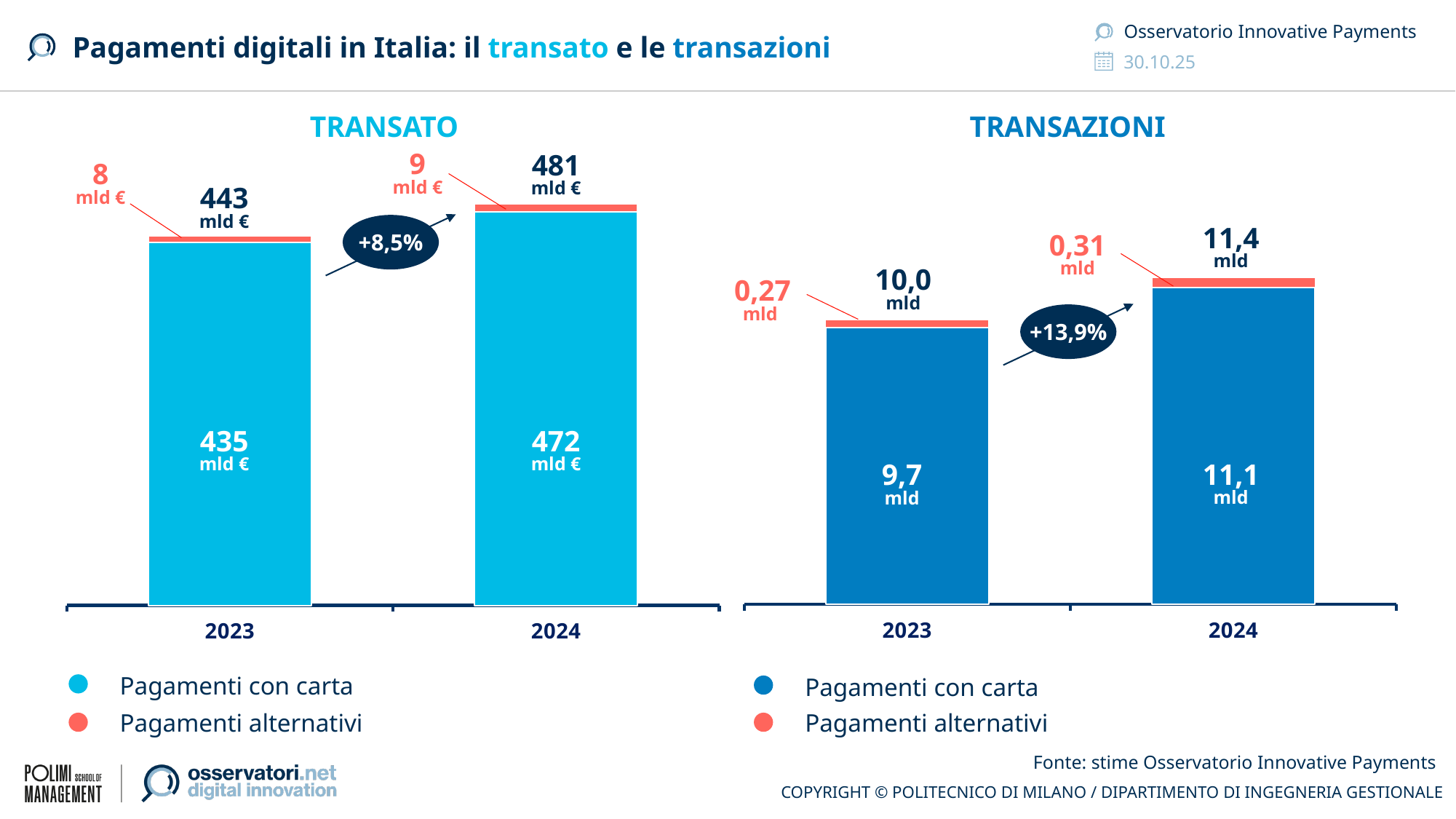
In the TRANSATO chart, what is the difference between the Pagamenti con carta values for 2024 and 2023? 37 mld € In the TRANSATO chart, what percentage growth is shown between 2023 and 2024? +8,5% In the TRANSATO chart, what is the value for Pagamenti con carta in 2023? 435 mld € In the TRANSAZIONI chart, what is the value for Pagamenti con carta in 2024? 11,1 mld In the TRANSATO chart, what is the value for Pagamenti alternativi in 2024? 9 mld € In the TRANSATO chart, what is the total of the stacked bar for 2024? 481 mld € In the TRANSAZIONI chart, what is the total of the stacked bar for 2023? 10,0 mld In the TRANSAZIONI chart, what is the value for Pagamenti alternativi in 2023? 0,27 mld In the TRANSAZIONI chart, which year has the higher total, 2023 or 2024? 2024 In the TRANSAZIONI chart, what percentage growth is shown between 2023 and 2024? +13,9% How many series does the legend of the TRANSATO chart list? 2 What kind of chart is the TRANSAZIONI chart? Stacked bar chart